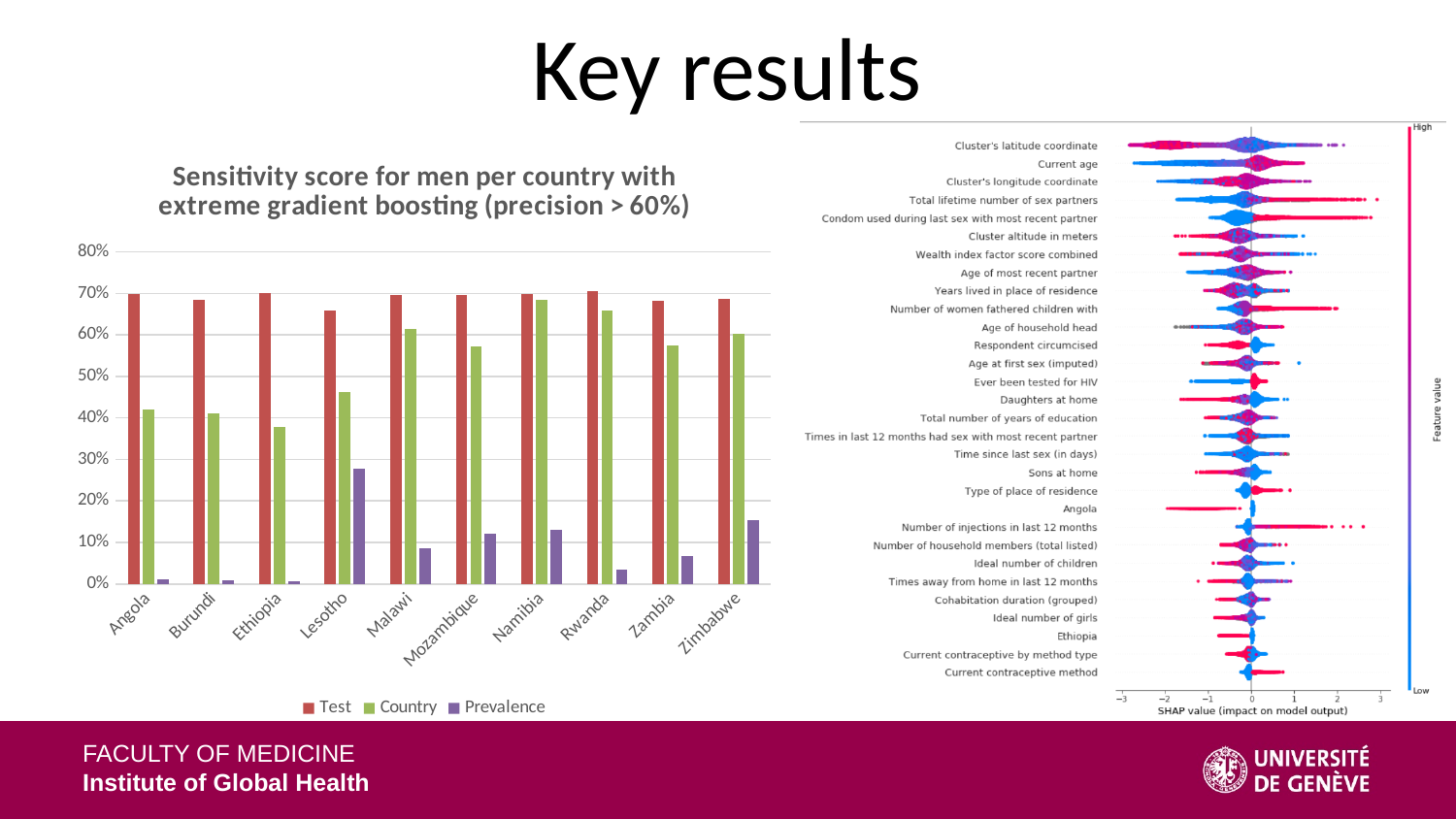
In the bar chart on the left, which country has the highest Prevalence value? Lesotho In the bar chart on the left, which series is shown in purple? Prevalence In the bar chart on the left, is the Prevalence value for Lesotho greater or less than 20%? greater In the bar chart on the left, which is larger: the Country value for Namibia or the Country value for Angola? Namibia What is the title of the bar chart on the left of the slide? Sensitivity score for men per country with extreme gradient boosting (precision > 60%) In the bar chart on the left, is the Country value for Mozambique greater or less than 60%? less How many countries are shown on the x axis of the bar chart on the left? 10 In the bar chart on the left, which is larger for Ethiopia: the Test value or the Country value? Test In the bar chart on the left, which country has the lowest Country value? Ethiopia How many series does the legend of the bar chart on the left list? 3 What kind of chart is the chart on the left of the slide? bar chart In the bar chart on the left, is the Country value for Ethiopia greater or less than 40%? less